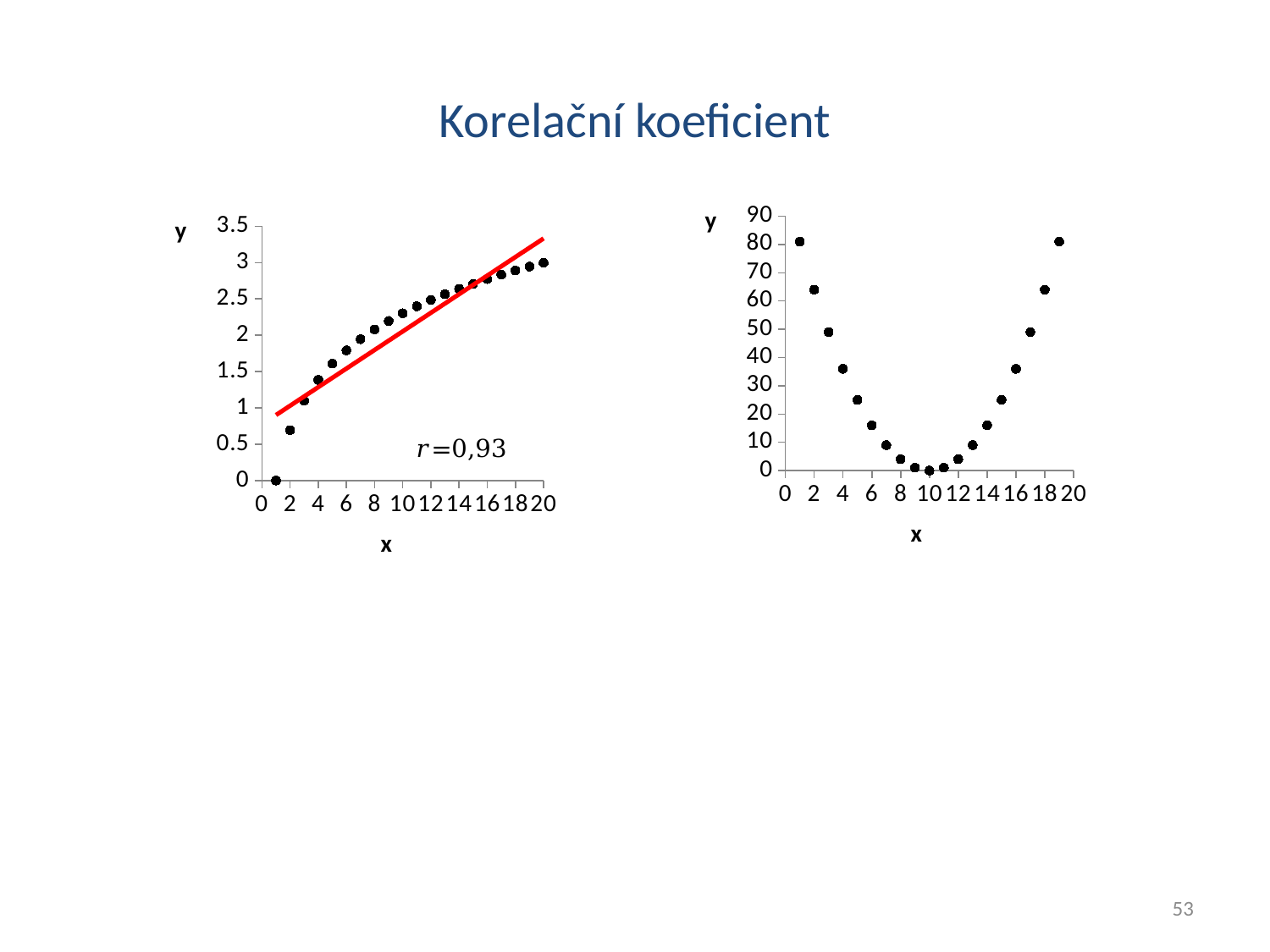
In the right chart, is the value of y at x = 1 greater or less than 70? greater In the right chart, what is the value of y at x = 10? 0 In the right chart, at which x value is y lowest? 10 In the left chart, is the value of y at x = 10 greater or less than 2? greater In the right chart, is the value of y at x = 5 greater or less than 30? less In the right chart, which has the larger y value: the point at x = 3 or the point at x = 7? x = 3 In the left chart, what colour is the fitted straight line drawn through the points? red What kind of chart is the right chart on the slide? scatter chart In the left chart, do the y values rise or fall as x increases? rise What kind of chart is the left chart on the slide? scatter chart In the left chart, what value of the correlation coefficient r is shown? r=0,93